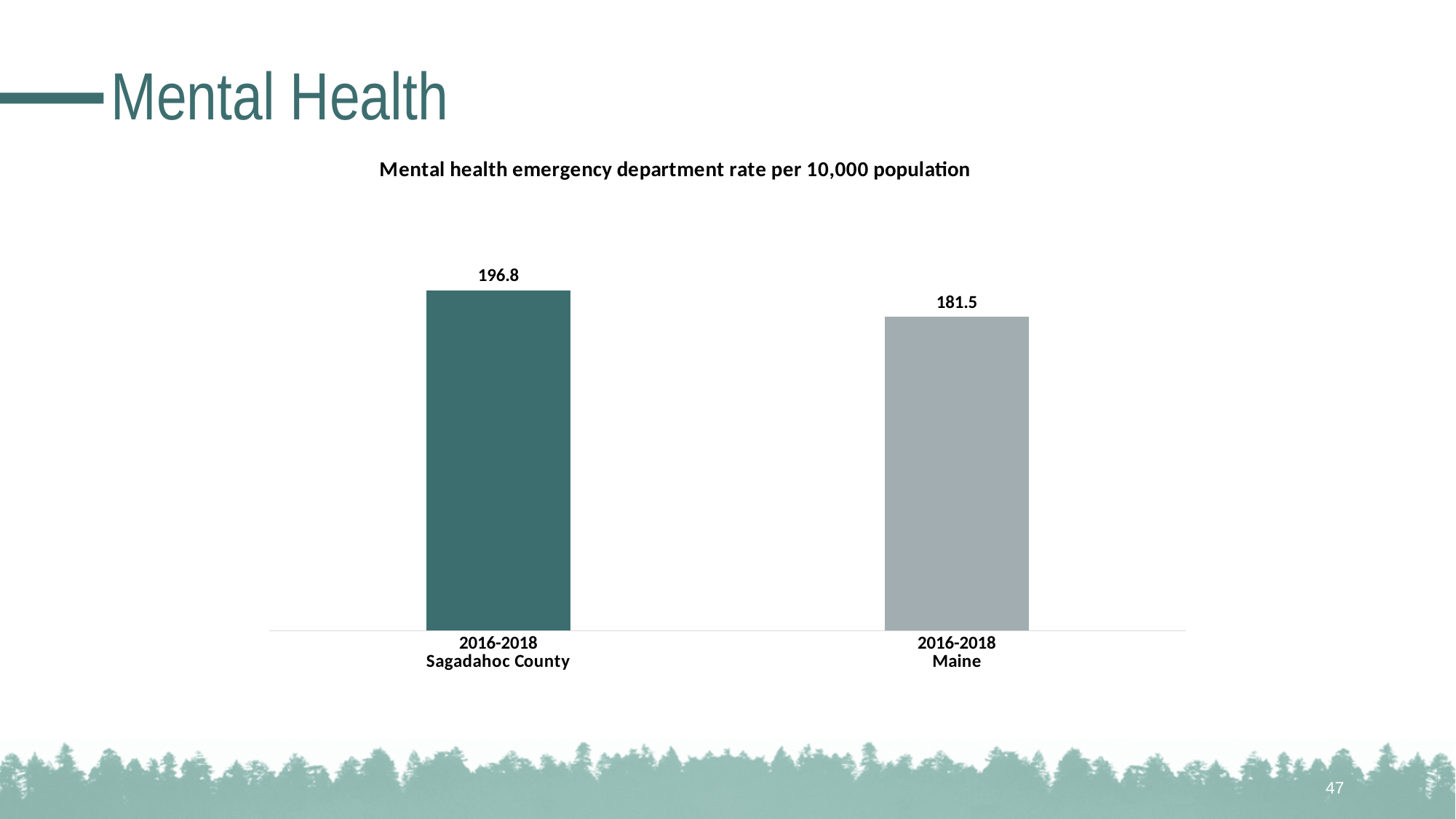
How many bars are shown on the chart? 2 What type of chart is shown on the slide? Bar chart Which category has the highest mental health emergency department rate on the chart? Sagadahoc County Which category has the higher mental health emergency department rate, Sagadahoc County or Maine? Sagadahoc County What is the mental health emergency department rate per 10,000 population for Maine in 2016-2018? 181.5 What is the difference between the Sagadahoc County rate and the Maine rate? 15.3 What time period do the bars on the chart cover? 2016-2018 Which category has the lowest mental health emergency department rate on the chart? Maine What is the title of the chart? Mental health emergency department rate per 10,000 population What is the mental health emergency department rate per 10,000 population for Sagadahoc County in 2016-2018? 196.8